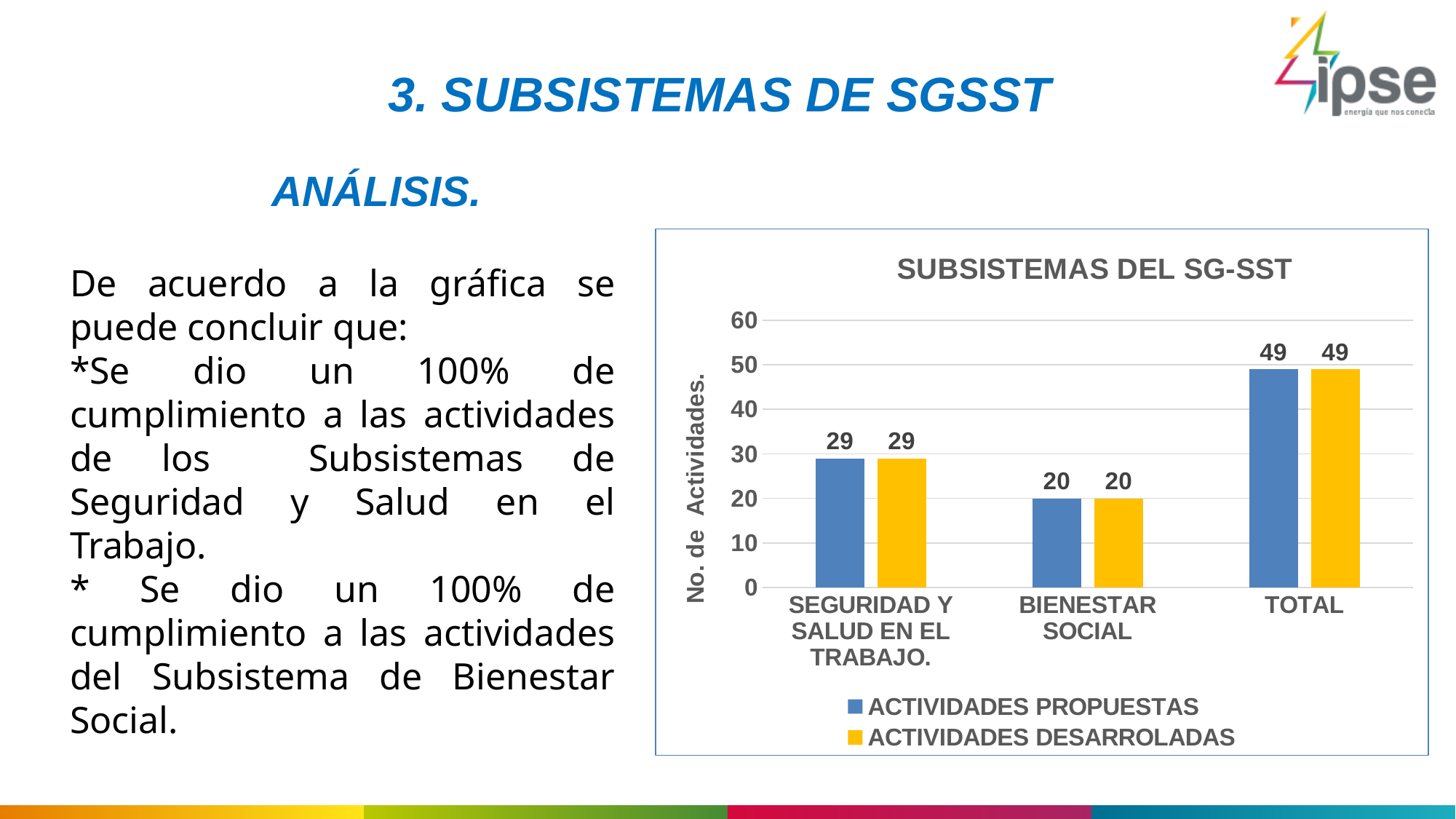
Which category has the highest value for ACTIVIDADES DESARROLADAS? TOTAL Is the value of ACTIVIDADES PROPUESTAS for TOTAL greater or less than 40? greater What kind of chart is shown on the slide? bar chart What is the difference between ACTIVIDADES PROPUESTAS for SEGURIDAD Y SALUD EN EL TRABAJO and for BIENESTAR SOCIAL? 9 What is the value of ACTIVIDADES PROPUESTAS for SEGURIDAD Y SALUD EN EL TRABAJO? 29 Which is larger: ACTIVIDADES DESARROLADAS for SEGURIDAD Y SALUD EN EL TRABAJO or for BIENESTAR SOCIAL? SEGURIDAD Y SALUD EN EL TRABAJO What is the value of ACTIVIDADES PROPUESTAS for TOTAL? 49 How many series does the legend list? 2 Which category has the lowest value for ACTIVIDADES PROPUESTAS? BIENESTAR SOCIAL What is the value of ACTIVIDADES DESARROLADAS for BIENESTAR SOCIAL? 20 What is the title of the chart? SUBSISTEMAS DEL SG-SST How many categories are shown on the x axis of the chart? 3